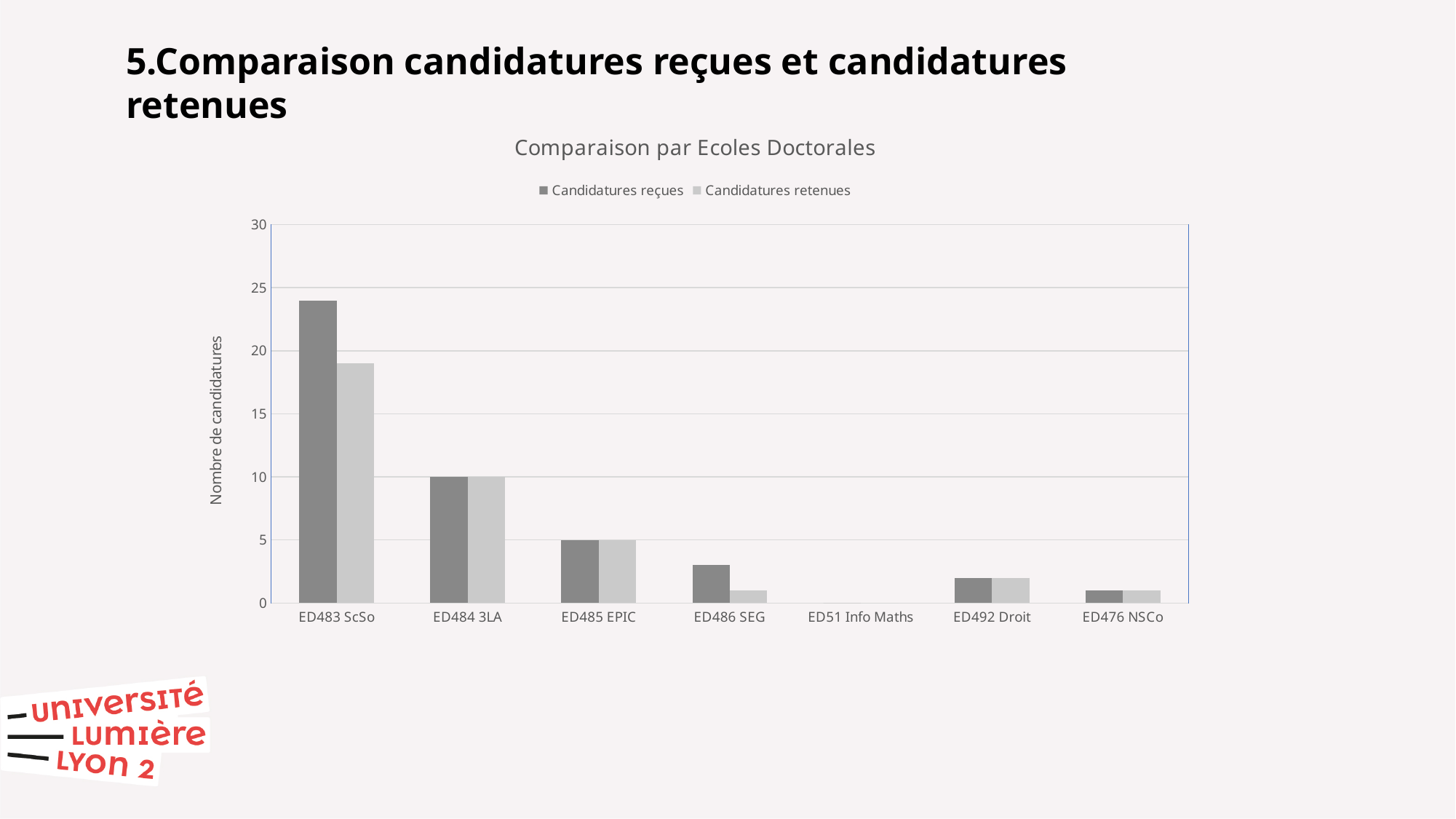
What is the value of Candidatures reçues for ED484 3LA? 10 Is the value of Candidatures reçues for ED483 ScSo greater or less than 20? greater For ED483 ScSo, which is larger: Candidatures reçues or Candidatures retenues? Candidatures reçues Is the value of Candidatures retenues for ED486 SEG greater or less than 5? less Which doctoral school has the highest number of Candidatures reçues? ED483 ScSo What is the value of Candidatures retenues for ED485 EPIC? 5 What is the label of the y axis? Nombre de candidatures How many series does the legend list? 2 What type of chart is shown on the slide? bar chart How many doctoral schools (categories) are shown on the x axis? 7 What is the title of the chart? Comparaison par Ecoles Doctorales Which doctoral school has the lowest number of Candidatures reçues? ED51 Info Maths